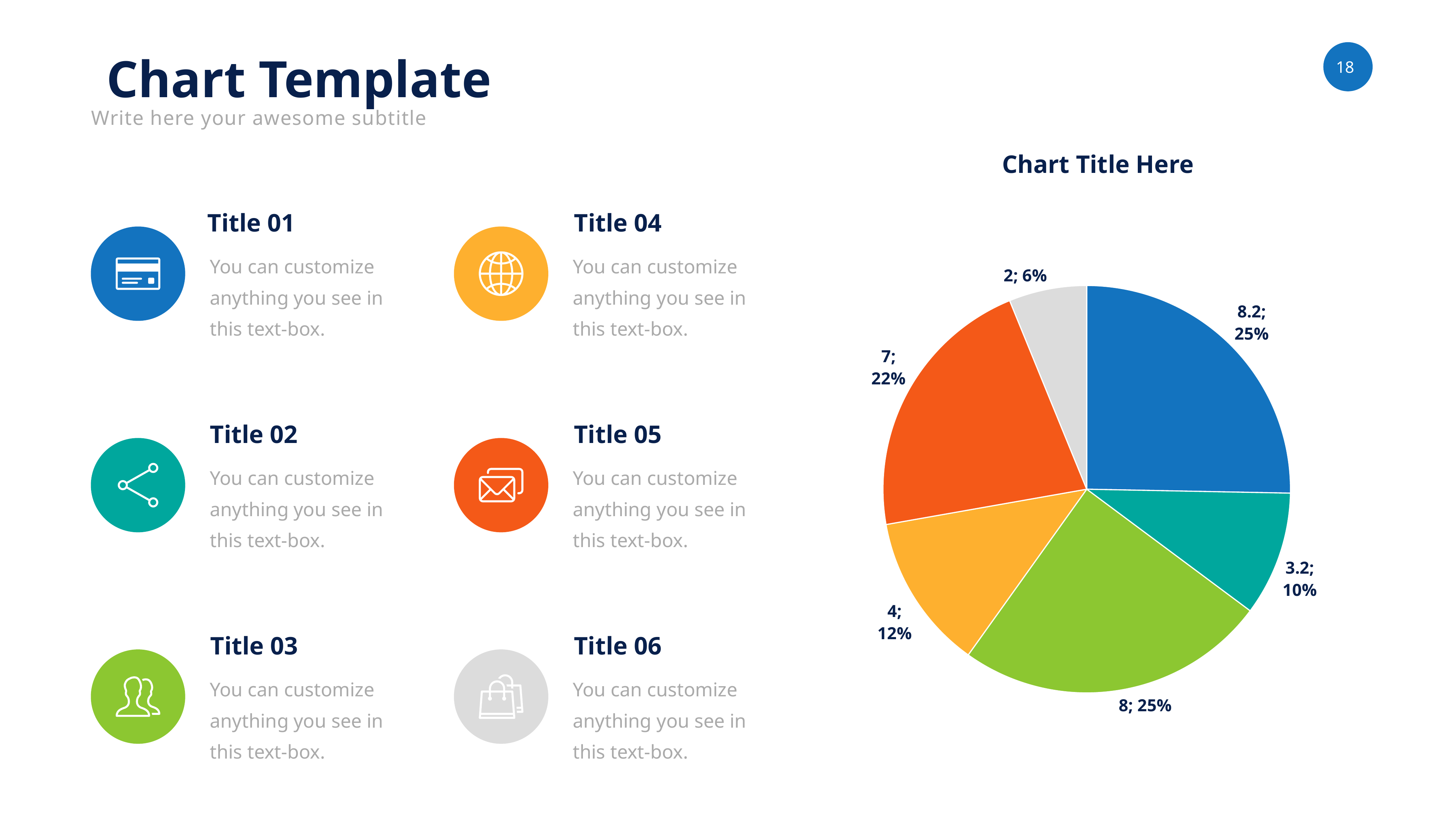
What share of the pie does the green slice represent? 25% Which slice has the smallest value in the pie chart? the grey slice (2; 6%) Which slice has the largest value in the pie chart? the blue slice (8.2; 25%) What is the difference between the value of the blue slice (8.2) and the teal slice (3.2)? 5 What value is labelled on the blue slice of the pie chart? 8.2 What share of the pie does the grey slice represent? 6% What kind of chart is shown on the slide? pie chart Which is larger, the value of the red-orange slice or the yellow-orange slice? the red-orange slice (7) What value is labelled on the teal slice of the pie chart? 3.2 What percentage is labelled on the yellow-orange slice? 12% What is the title of the chart? Chart Title Here How many slices does the pie chart have? 6